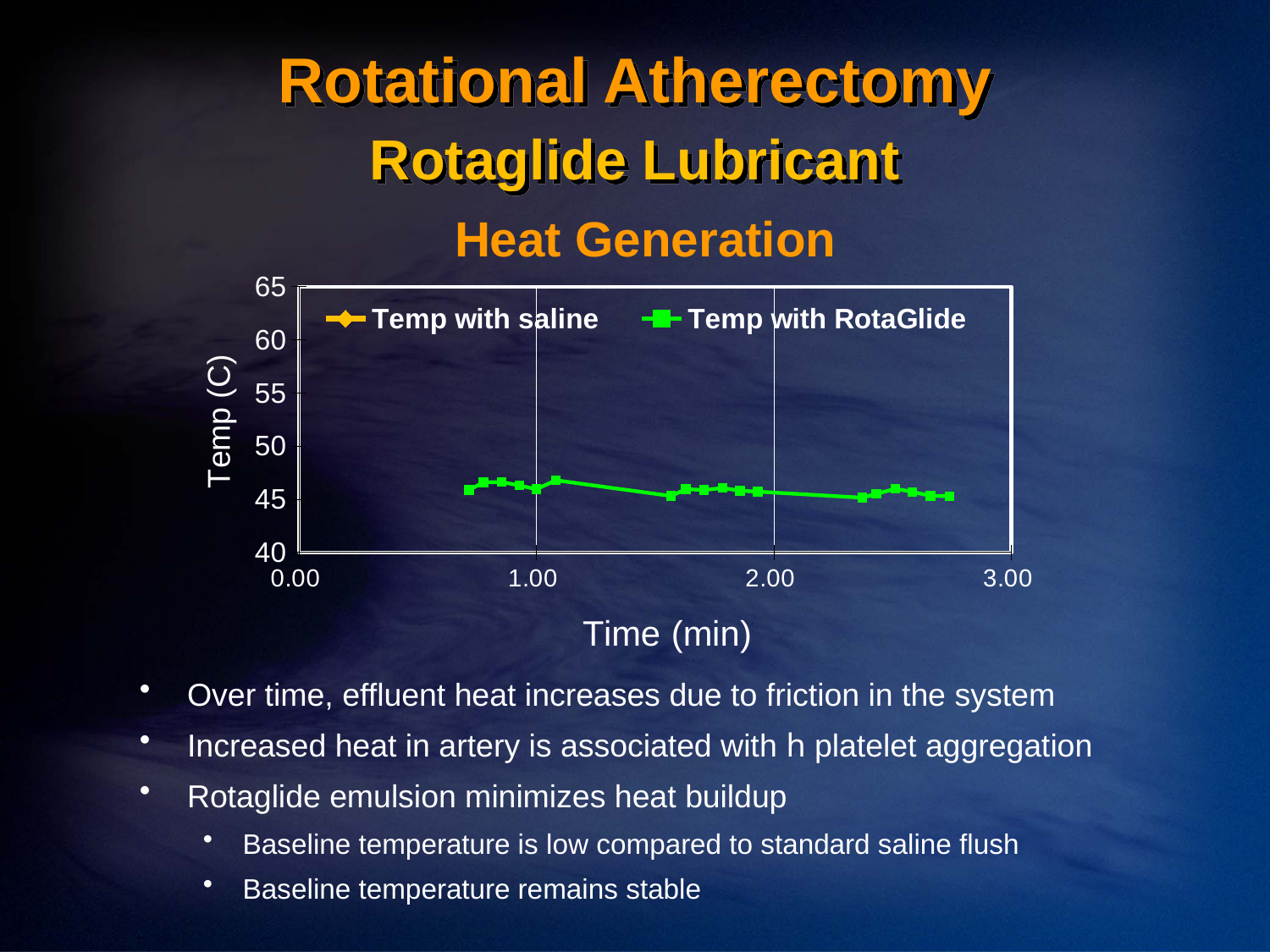
Does the Temp with RotaGlide series rise sharply, fall sharply, or stay roughly flat across the time axis? stay roughly flat Is the value for Temp with RotaGlide at 2.00 min greater or less than 55? less Is the value for Temp with RotaGlide at 1.00 min greater or less than 40? greater How many series does the chart legend list? 2 What kind of chart is shown on the slide? line chart What is the label of the y axis of the chart? Temp (C) What is the title of the chart? Heat Generation Is the value for Temp with RotaGlide at 1.00 min greater or less than 50? less What is the highest value shown on the y axis of the chart? 65